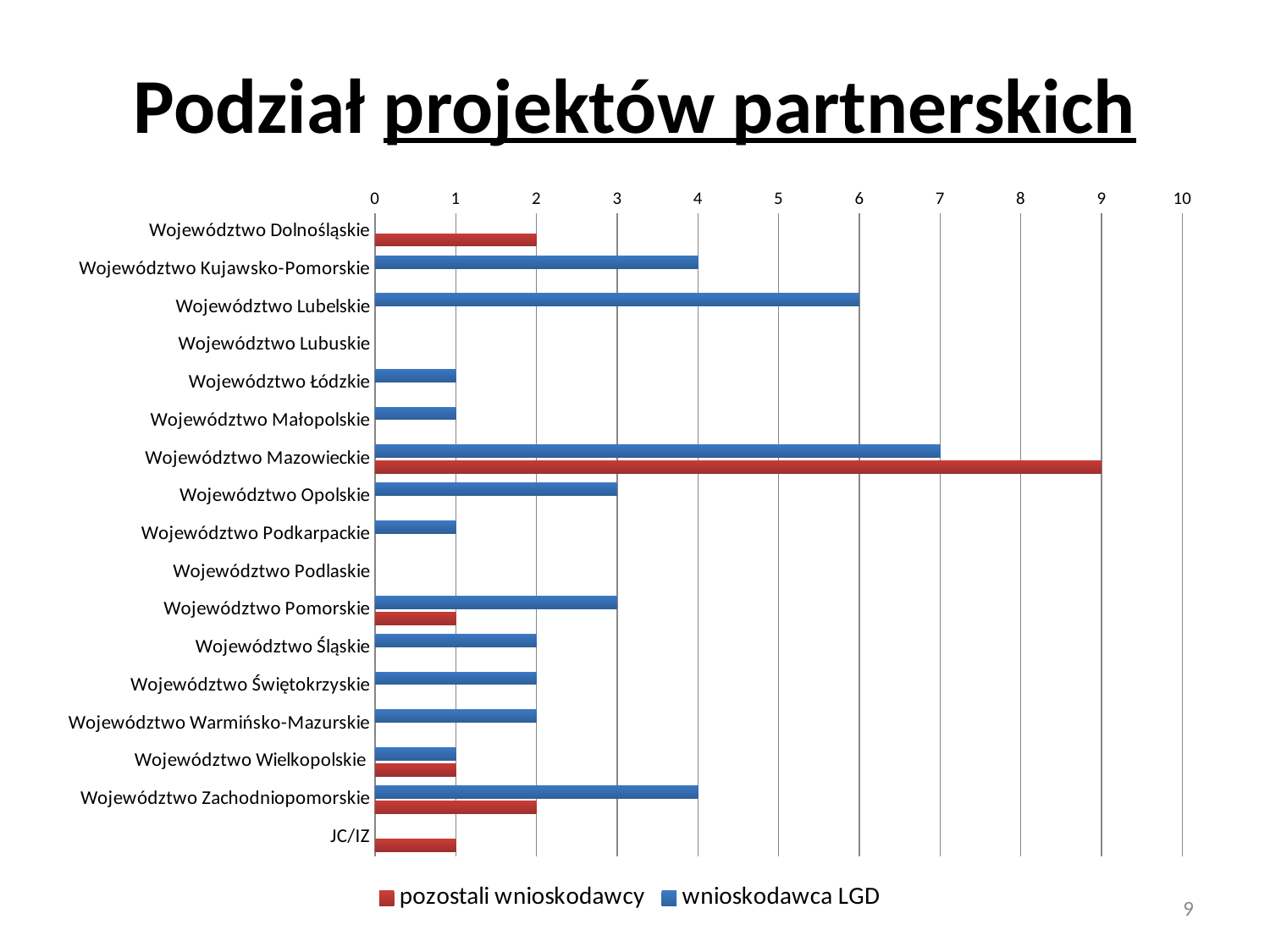
Which colour represents the series "wnioskodawca LGD" in the legend? blue Which has a larger "wnioskodawca LGD" value: Województwo Kujawsko-Pomorskie or Województwo Opolskie? Województwo Kujawsko-Pomorskie For Województwo Mazowieckie, what is the difference between "pozostali wnioskodawcy" and "wnioskodawca LGD"? 2 What is the value of "pozostali wnioskodawcy" for Województwo Mazowieckie? 9 What is the value of "wnioskodawca LGD" for Województwo Zachodniopomorskie? 4 Which category has the highest value for "pozostali wnioskodawcy"? Województwo Mazowieckie What kind of chart is shown on the slide? bar chart Is the "wnioskodawca LGD" value for Województwo Lubelskie greater or less than 5? greater What is the value of "wnioskodawca LGD" for Województwo Lubelskie? 6 Which category has the highest value for "wnioskodawca LGD"? Województwo Mazowieckie How many categories are listed on the vertical axis of the chart? 17 How many series does the legend list? 2